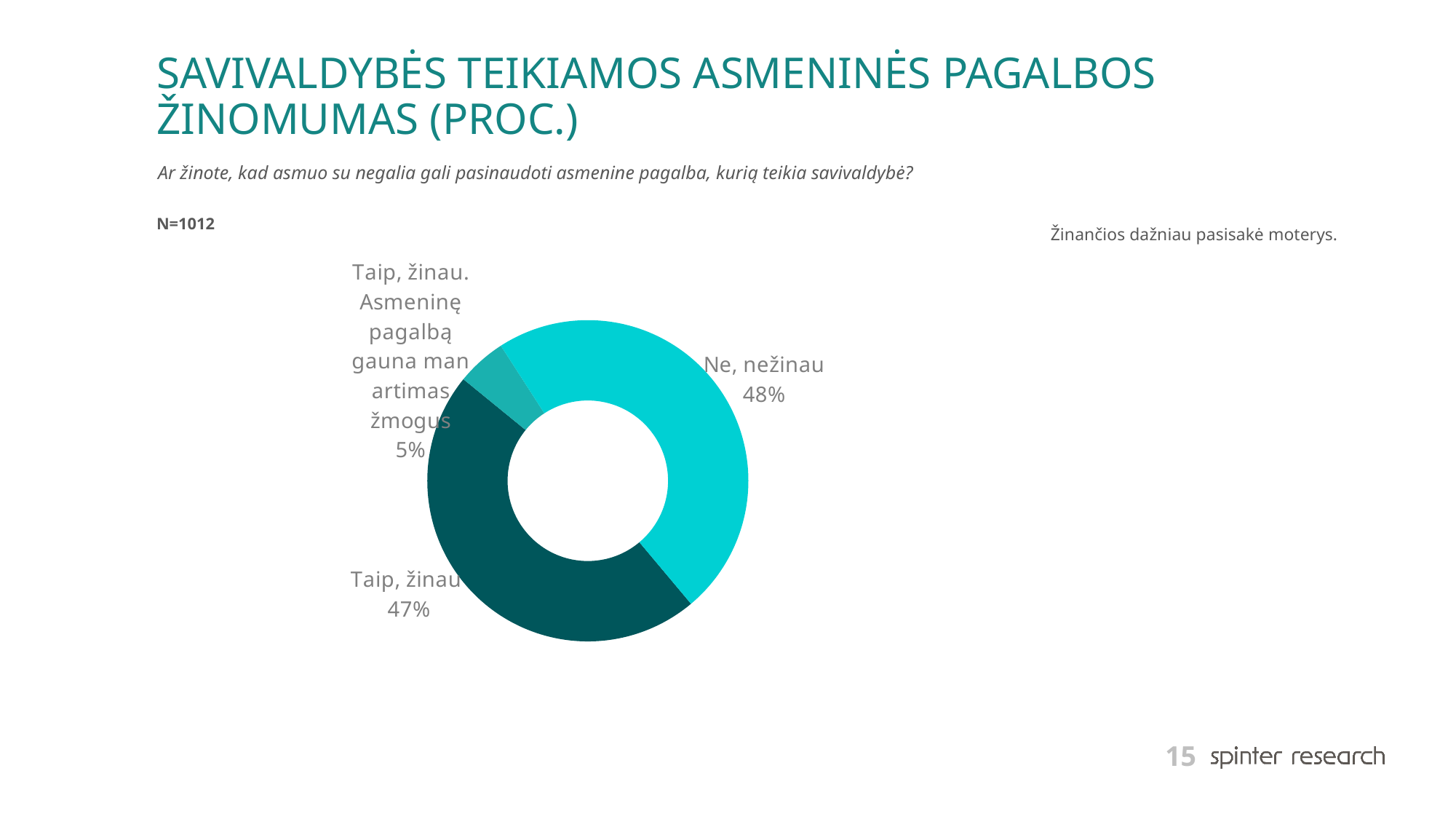
What percentage is shown for "Taip, žinau"? 47% What percentage is shown for "Ne, nežinau"? 48% What kind of chart is shown on the slide? Pie chart (donut) What is the difference in percentage points between "Ne, nežinau" and "Taip, žinau"? 1 percentage point What percentage is shown for "Taip, žinau. Asmeninę pagalbą gauna man artimas žmogus"? 5% What share of the pie does "Ne, nežinau" take? 48% What is the sample size (N) stated on the slide? N=1012 How many slices does the pie chart have? 3 Which slice of the pie chart is the smallest? Taip, žinau. Asmeninę pagalbą gauna man artimas žmogus Which slice of the pie chart is the largest? Ne, nežinau Which is larger: the share for "Taip, žinau" or the share for "Taip, žinau. Asmeninę pagalbą gauna man artimas žmogus"? Taip, žinau What is the title of the slide? SAVIVALDYBĖS TEIKIAMOS ASMENINĖS PAGALBOS ŽINOMUMAS (PROC.)